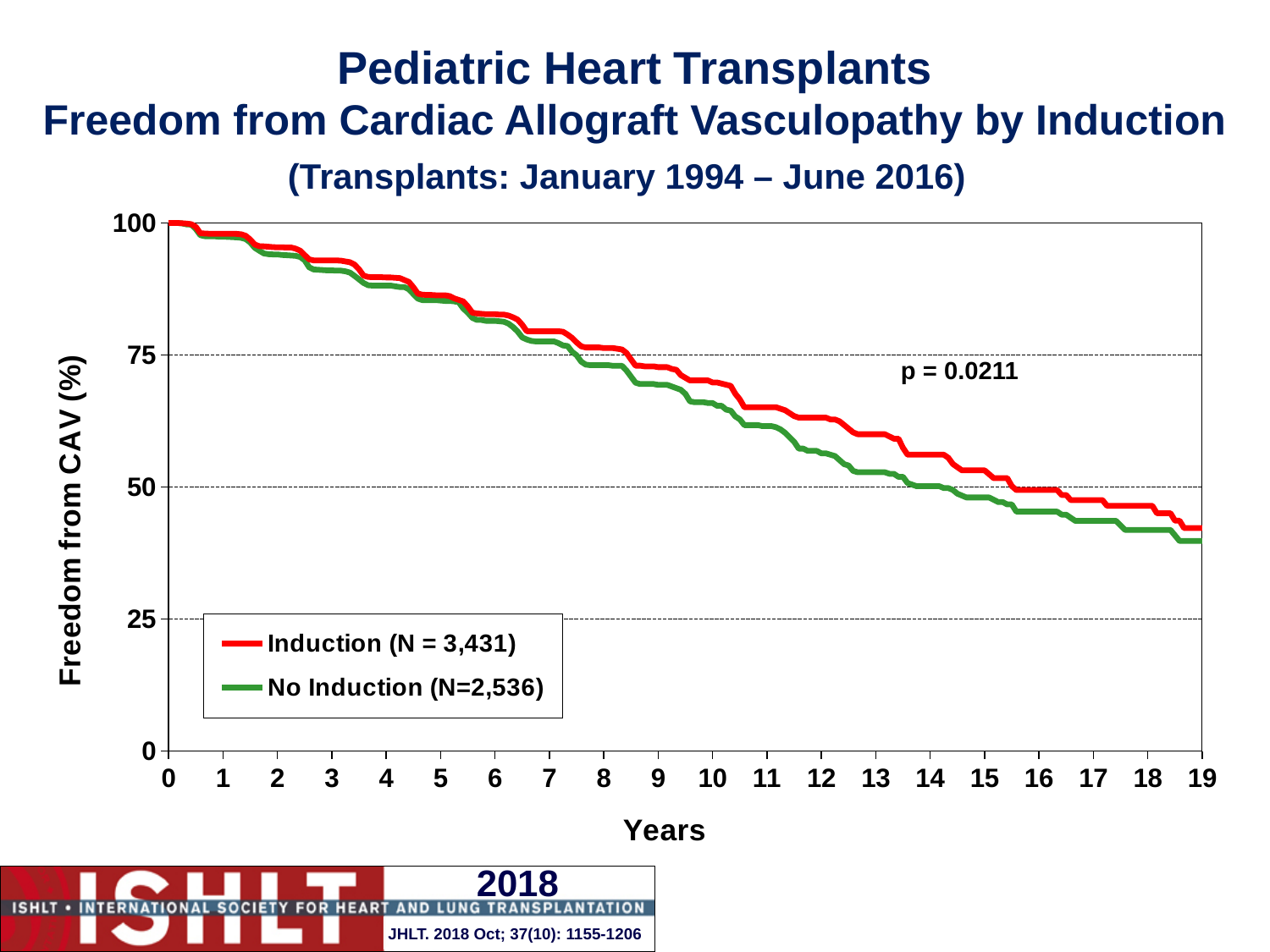
How many series does the legend list? 2 Is the freedom from CAV for the No Induction group at year 17 greater or less than 50? less What kind of chart is shown on the slide? Line chart What is the N for the No Induction group shown in the legend? 2,536 Is the freedom from CAV for the Induction group at year 10 greater or less than 50? greater Do the freedom from CAV values rise or fall as years increase? Fall What p-value is printed on the chart? p = 0.0211 Is the freedom from CAV for the No Induction group at year 19 greater or less than 50? less What is the freedom from CAV (%) for both groups at year 0? 100 At year 12, which group has the higher freedom from CAV, Induction or No Induction? Induction What is the N for the Induction group shown in the legend? 3,431